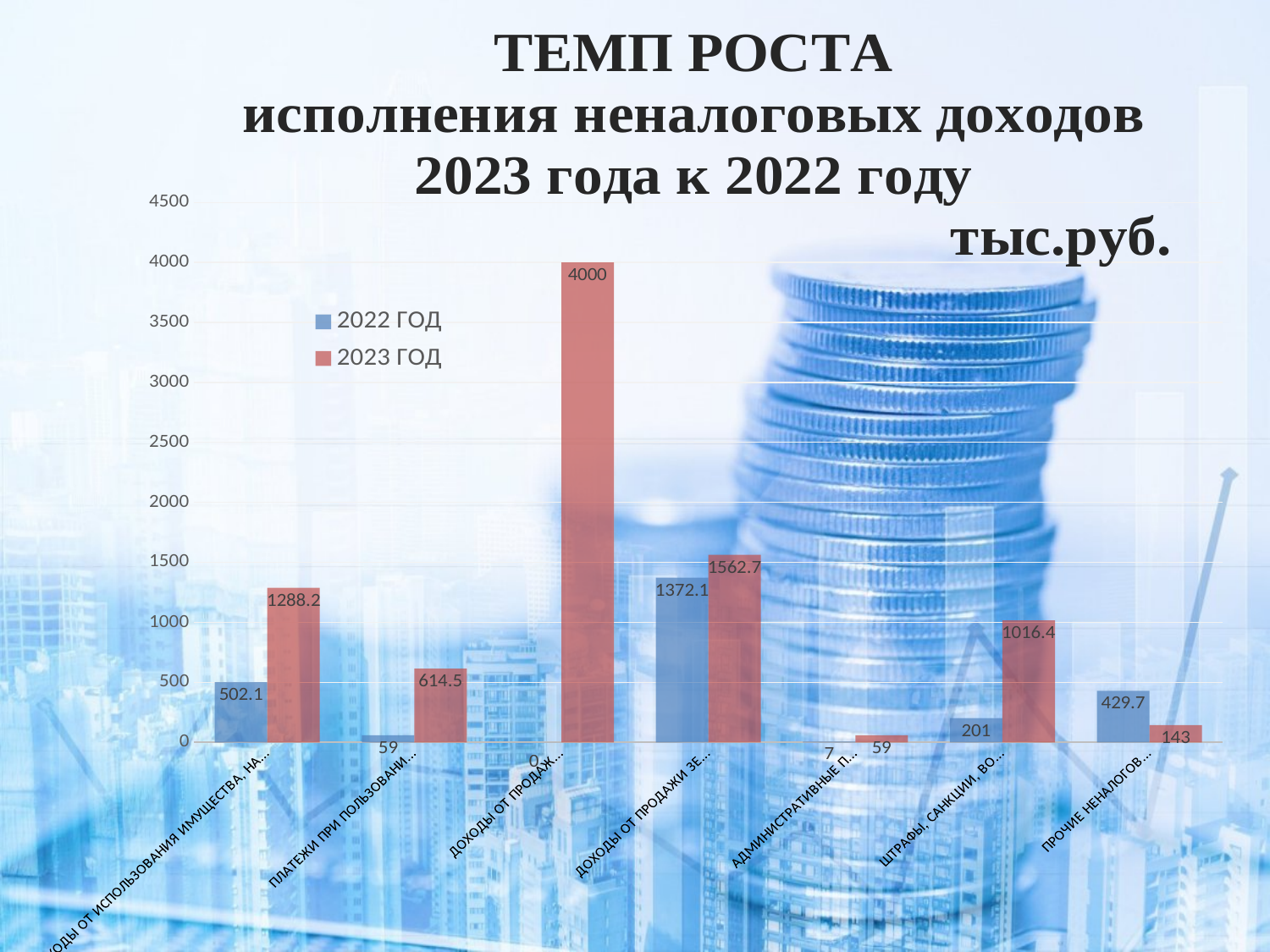
What is the value for 2022 ГОД in the category labelled "АДМИНИСТРАТИВНЫЕ П..."? 7 What is the value for 2023 ГОД in the category labelled "ШТРАФЫ, САНКЦИИ, ВО..."? 1016.4 In the first category ("...ОДЫ ОТ ИСПОЛЬЗОВАНИЯ ИМУЩЕСТВА, НА..."), what is the difference between the 2023 ГОД value and the 2022 ГОД value? 786.1 How many categories are shown on the x axis of the chart? 7 What is the lowest value shown for the 2022 ГОД series? 0 What is the value for 2022 ГОД in the category labelled "ПРОЧИЕ НЕНАЛОГОВ..."? 429.7 How many series does the chart legend list? 2 In the category labelled "ДОХОДЫ ОТ ПРОДАЖИ ЗЕ...", what is the difference between the 2023 ГОД value and the 2022 ГОД value? 190.6 What type of chart is shown on the slide? Bar chart In the category labelled "ПРОЧИЕ НЕНАЛОГОВ...", which series has the larger value, 2022 ГОД or 2023 ГОД? 2022 ГОД What is the highest value shown for the 2023 ГОД series? 4000 In the category labelled "ШТРАФЫ, САНКЦИИ, ВО...", how much larger is the 2023 ГОД value than the 2022 ГОД value? 815.4